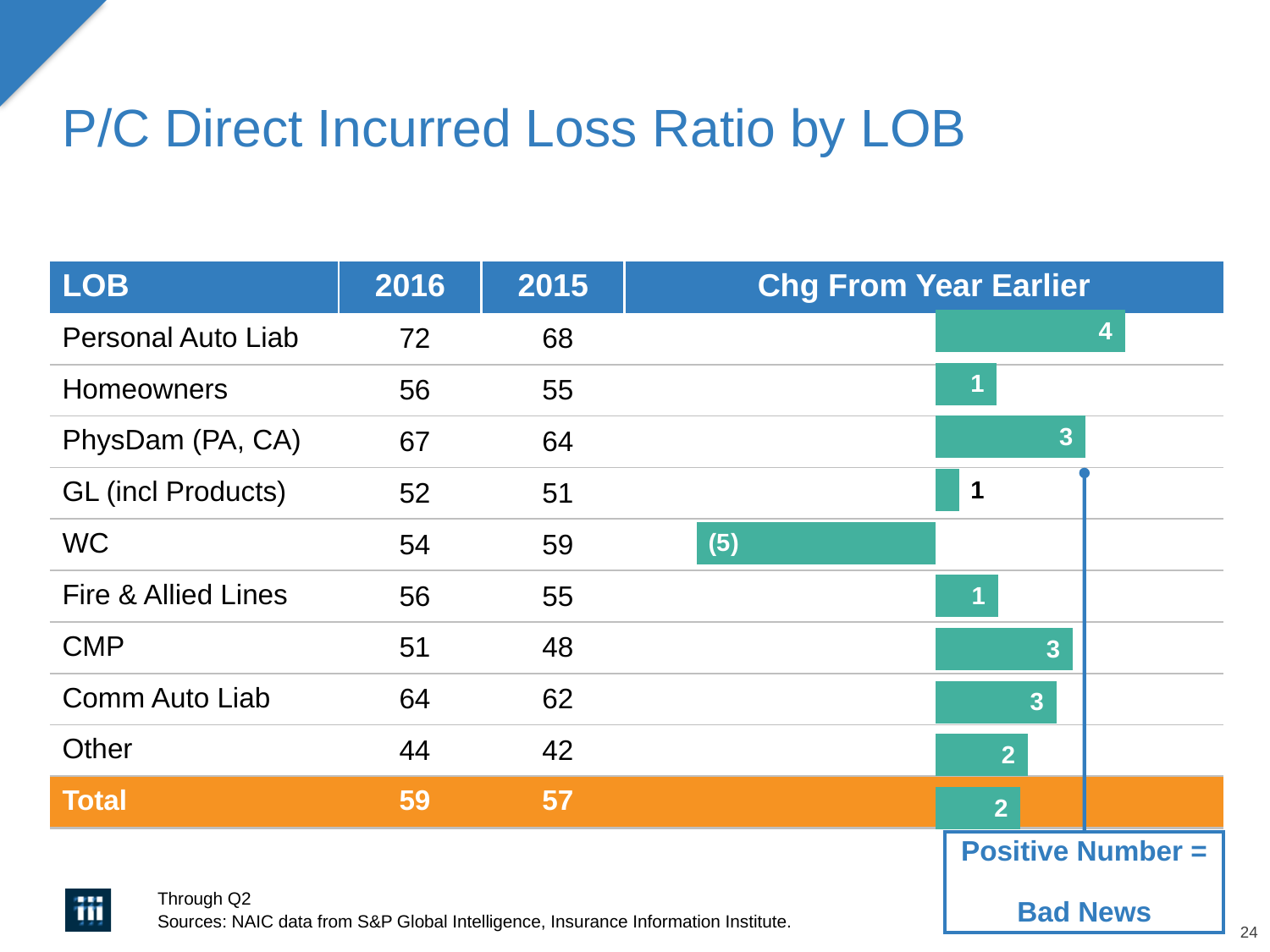
What is the change from a year earlier shown for Other? 2 According to the note on the slide, what does a positive number mean? Bad News What is the difference between the change from a year earlier for Personal Auto Liab and for Other? 2 What kind of chart is shown in the 'Chg From Year Earlier' column? bar chart Which LOB is the only one with a negative change from a year earlier? WC Which LOB has the largest positive change from a year earlier? Personal Auto Liab What is the change from a year earlier shown for the Total row? 2 Which LOB has the lowest change from a year earlier? WC What is the change from a year earlier shown for WC? (5) What is the change from a year earlier shown for Personal Auto Liab? 4 How many rows (including Total) have a bar in the 'Chg From Year Earlier' column? 10 Is the change from a year earlier larger for Personal Auto Liab or for Homeowners? Personal Auto Liab